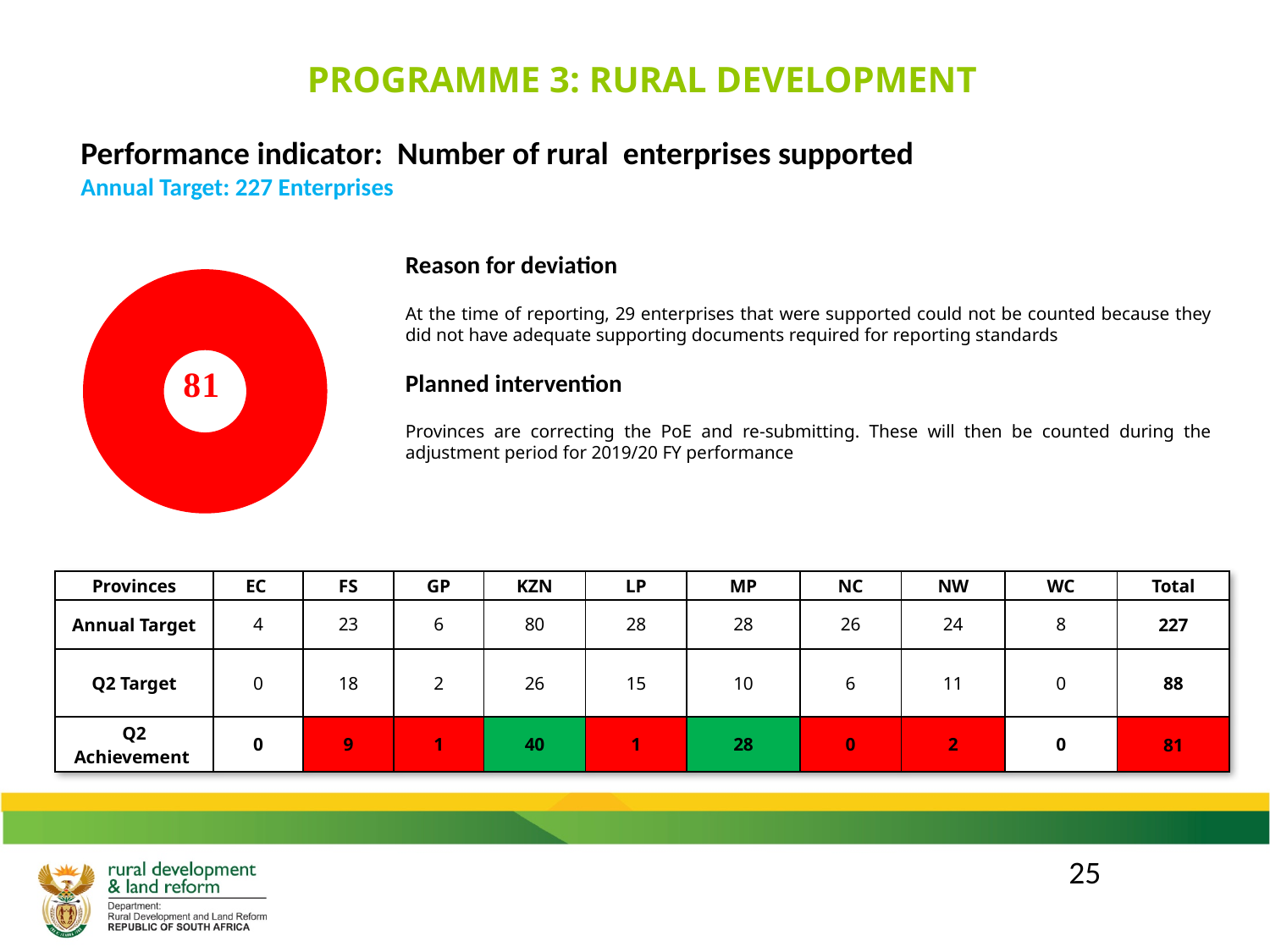
How many distinct segments are visible in the doughnut chart's ring? 1 What value is printed in the centre of the doughnut chart? 81 What kind of chart is shown on the left of the slide? doughnut chart Is the value shown in the centre of the doughnut chart greater or less than 50? greater What colour is the ring of the doughnut chart? red